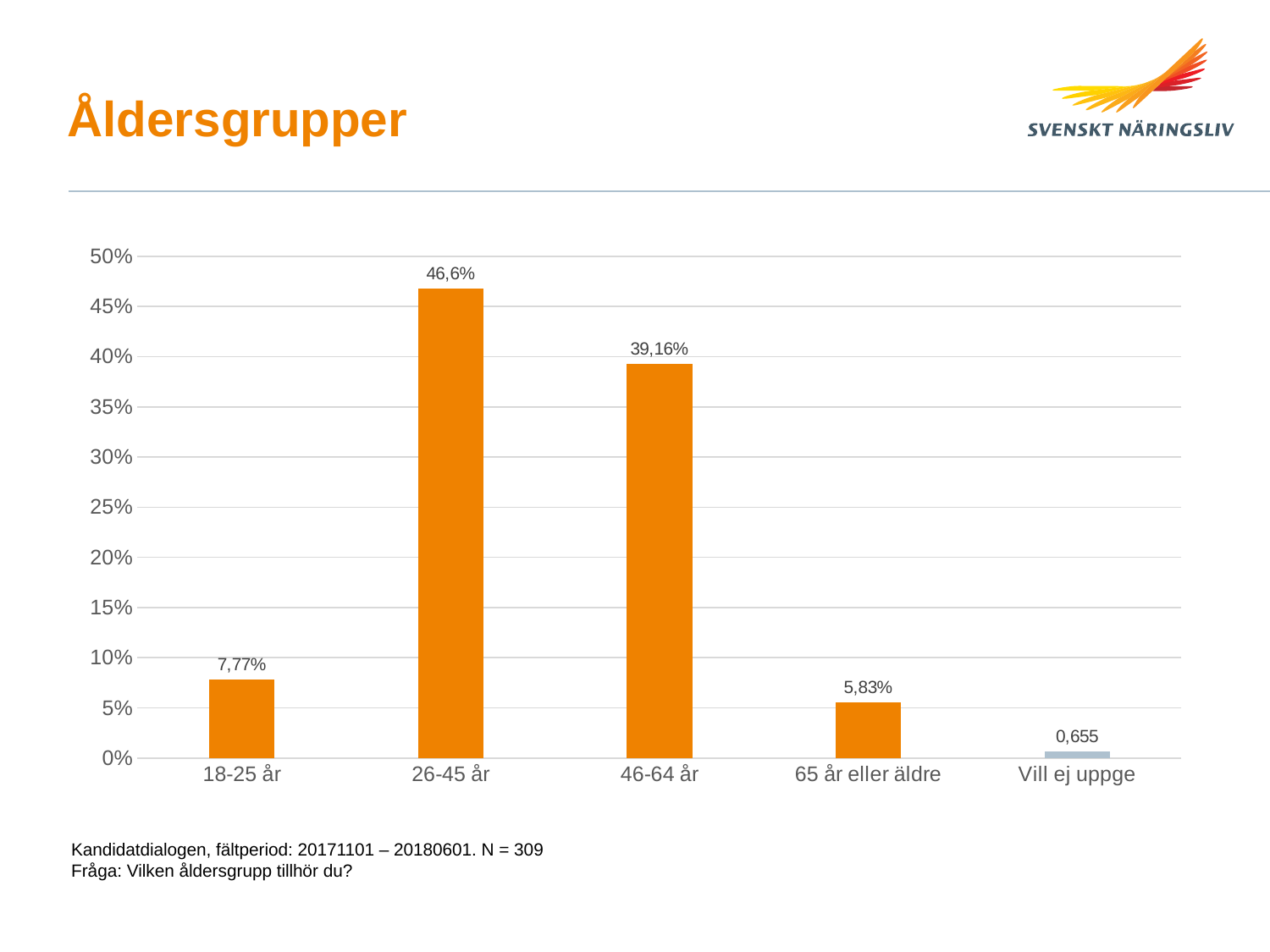
Which age group has the highest value? 26-45 år What kind of chart is shown on the slide? Bar chart What is the value for the 46-64 år age group? 39,16% What is the value for the 18-25 år age group? 7,77% Which is larger, the value for 18-25 år or for 65 år eller äldre? 18-25 år What data label is shown for the Vill ej uppge bar? 0,655 What is the value for 65 år eller äldre? 5,83% What is the difference between the values for 26-45 år and 46-64 år? 7,44% What is the value for the 26-45 år age group? 46,6% Is the value for 46-64 år greater or less than 35%? greater Which category has the lowest value? Vill ej uppge How many categories are shown on the x axis? 5